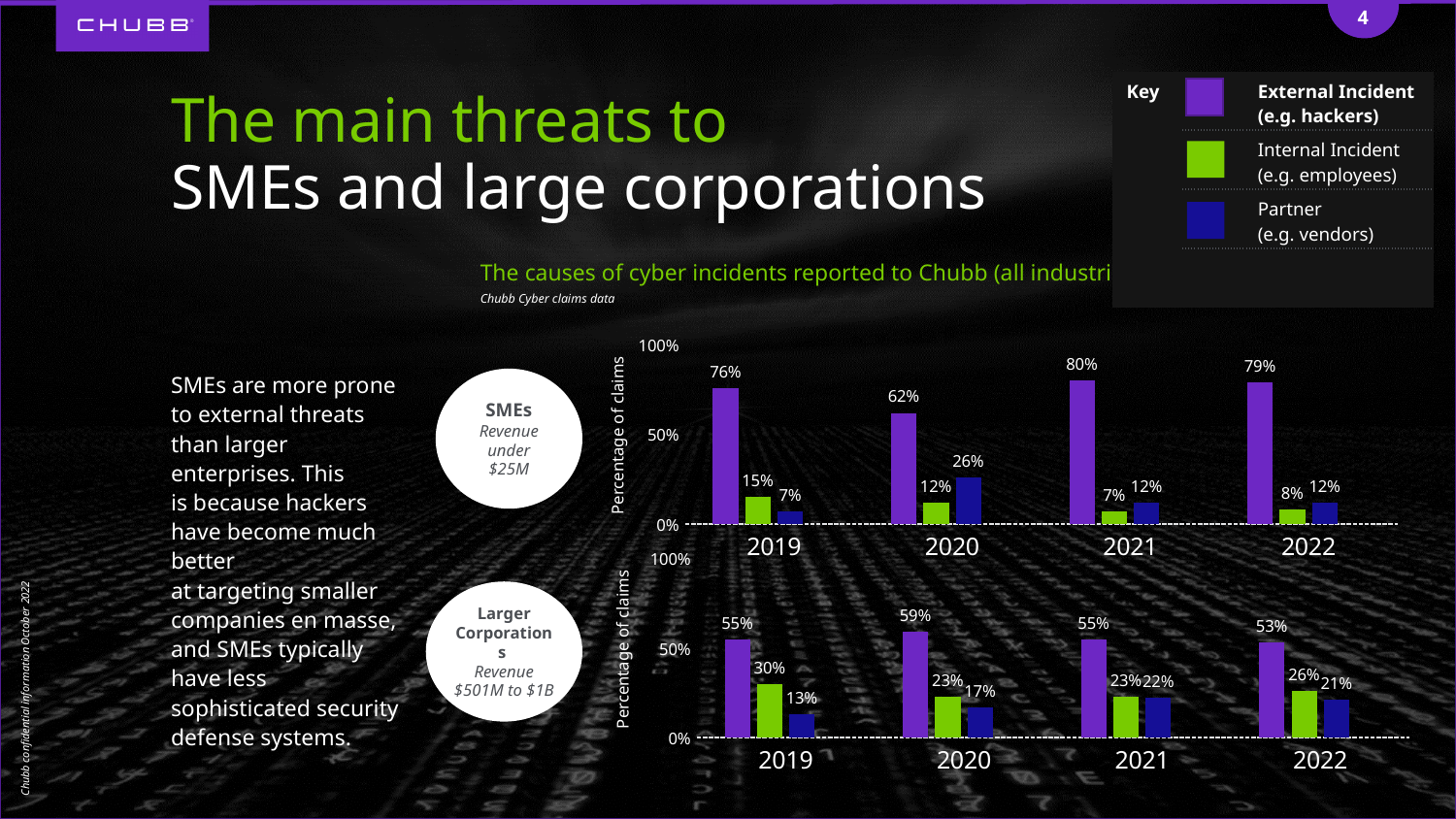
In the SMEs chart, which year has the highest External Incident percentage? 2021 In the Larger Corporations chart, which year has the lowest External Incident percentage? 2022 In the Larger Corporations chart, which is larger in 2020: Internal Incident or Partner? Internal Incident Which colour represents Partner (e.g. vendors) in the key? Dark blue In the SMEs chart, what is the difference between the External Incident percentage and the Internal Incident percentage in 2019? 61% In the Larger Corporations chart, what percentage of claims in 2019 were Internal Incidents? 30% In the SMEs chart, what percentage of claims in 2020 were Partner incidents? 26% What type of chart is used to show the causes of cyber incidents for SMEs? Bar chart In the SMEs chart, what percentage of claims in 2021 were External Incidents? 80% How many series does the key list for the charts? 3 How many years are shown on the x axis of the SMEs chart? 4 In the Larger Corporations chart, is the External Incident value for 2021 greater or less than 50%? greater